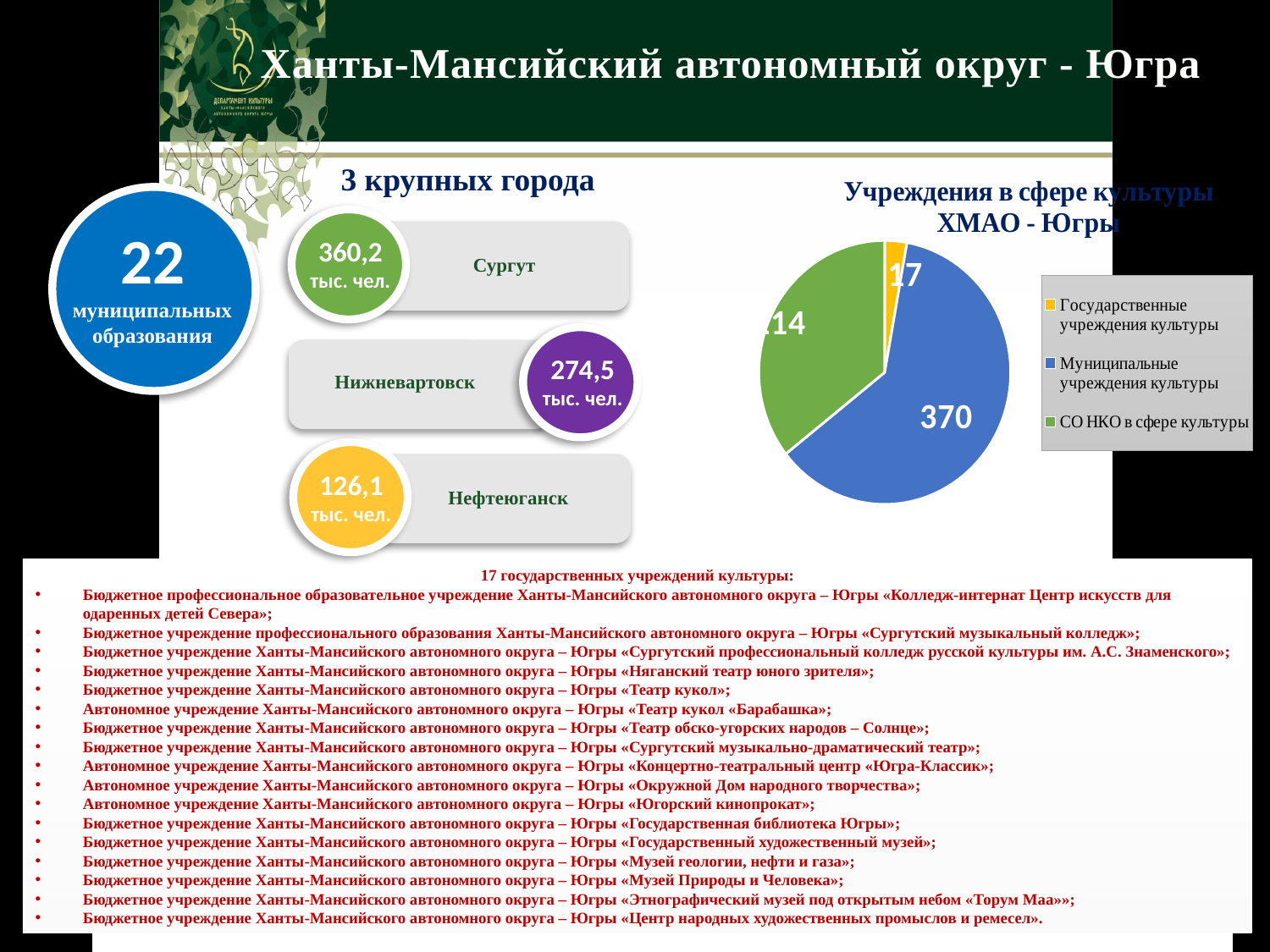
How many entries does the legend of the pie chart "Учреждения в сфере культуры ХМАО - Югры" list? 3 How many slices does the pie chart "Учреждения в сфере культуры ХМАО - Югры" have? 3 In the pie chart "Учреждения в сфере культуры ХМАО - Югры", which category has the smallest slice? Государственные учреждения культуры In the pie chart "Учреждения в сфере культуры ХМАО - Югры", what is the value for Муниципальные учреждения культуры? 370 What kind of chart is shown under the title "Учреждения в сфере культуры ХМАО - Югры"? pie chart In the pie chart "Учреждения в сфере культуры ХМАО - Югры", which category has the largest slice? Муниципальные учреждения культуры In the pie chart "Учреждения в сфере культуры ХМАО - Югры", which is larger: Муниципальные учреждения культуры or СО НКО в сфере культуры? Муниципальные учреждения культуры In the pie chart "Учреждения в сфере культуры ХМАО - Югры", what is the difference between the values for Муниципальные учреждения культуры and Государственные учреждения культуры? 353 In the pie chart "Учреждения в сфере культуры ХМАО - Югры", which is larger: СО НКО в сфере культуры or Государственные учреждения культуры? СО НКО в сфере культуры In the pie chart "Учреждения в сфере культуры ХМАО - Югры", what is the value for Государственные учреждения культуры? 17 In the pie chart "Учреждения в сфере культуры ХМАО - Югры", which legend entry is shown in green? СО НКО в сфере культуры In the pie chart "Учреждения в сфере культуры ХМАО - Югры", what colour is the slice for Муниципальные учреждения культуры? blue